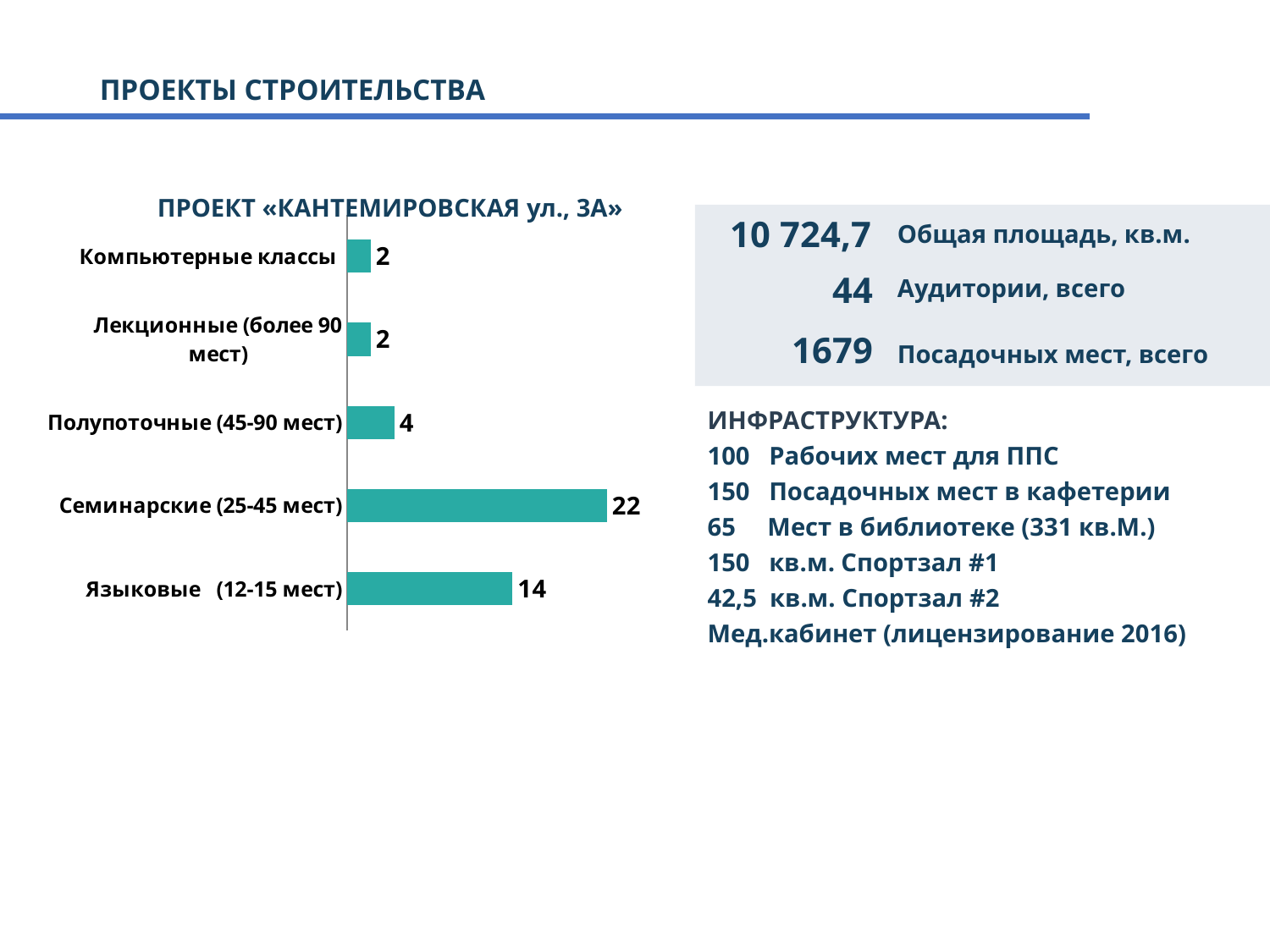
What is the difference between the values for Полупоточные (45-90 мест) and Лекционные (более 90 мест)? 2 What is the difference between the values for Семинарские (25-45 мест) and Языковые (12-15 мест)? 8 What kind of chart is shown on the slide? bar chart What is the value for Языковые (12-15 мест)? 14 What is the value for Компьютерные классы? 2 Which is larger, the value for Языковые (12-15 мест) or Полупоточные (45-90 мест)? Языковые (12-15 мест) How many categories are shown in the chart? 5 What is the value for Полупоточные (45-90 мест)? 4 What is the title of the chart? ПРОЕКТ «КАНТЕМИРОВСКАЯ ул., 3А» Which category has the highest value? Семинарские (25-45 мест) What is the value for Семинарские (25-45 мест)? 22 What is the total of all the values shown in the chart? 44